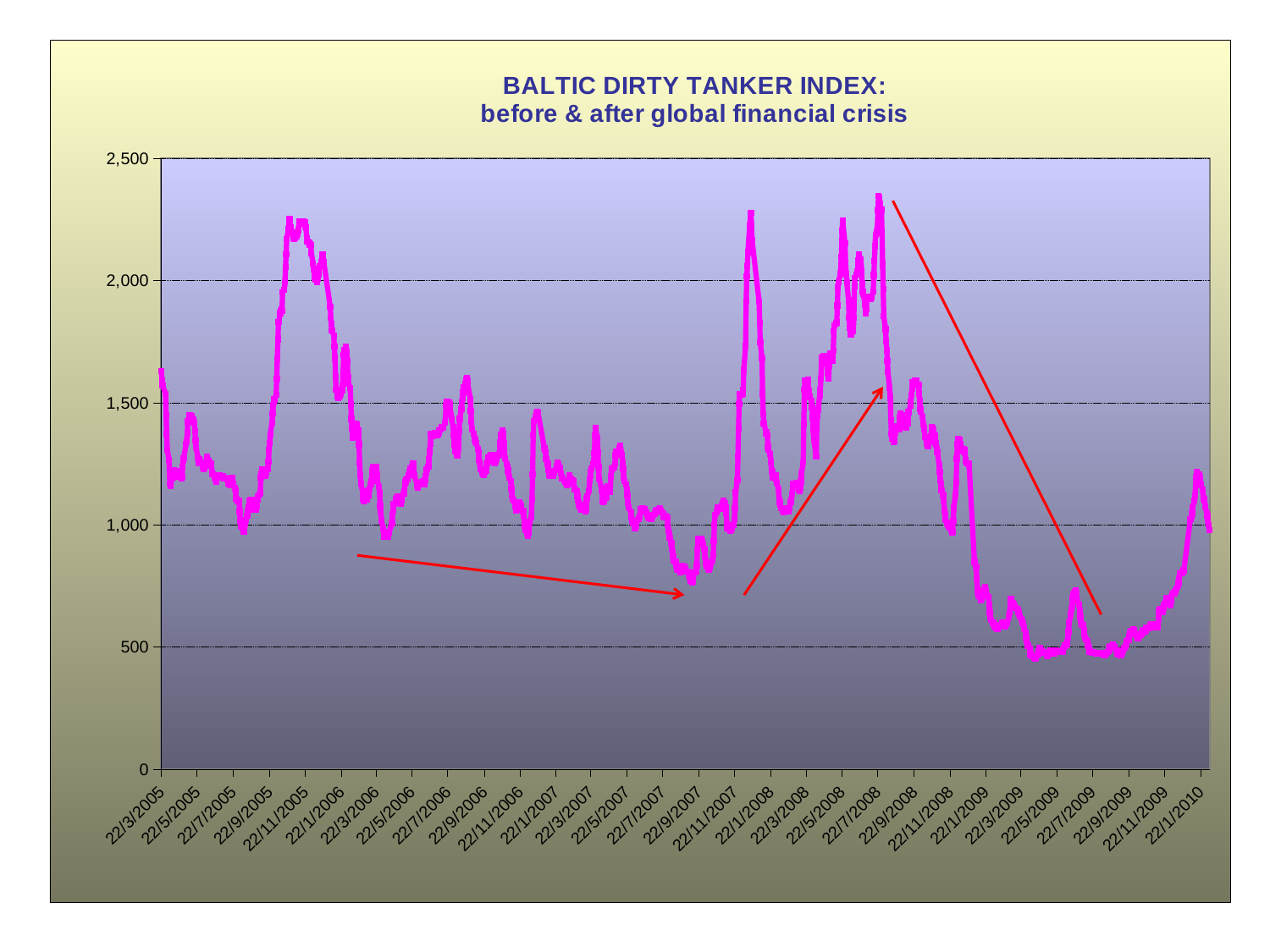
Is the value of the index around 22/9/2007 greater or less than 1,000? less Does the index rise or fall between 22/9/2009 and 22/1/2010? rise How many date labels are shown on the x axis? 30 Does the index rise or fall between 22/7/2008 and 22/7/2009? fall What kind of chart is shown on the slide? line chart Is the value of the index around 22/3/2009 greater or less than 1,000? less In which year does the index reach its highest peak? 2008 Is the value of the index around 22/7/2008 greater or less than 2,000? greater What is the title of the chart? BALTIC DIRTY TANKER INDEX: before & after global financial crisis